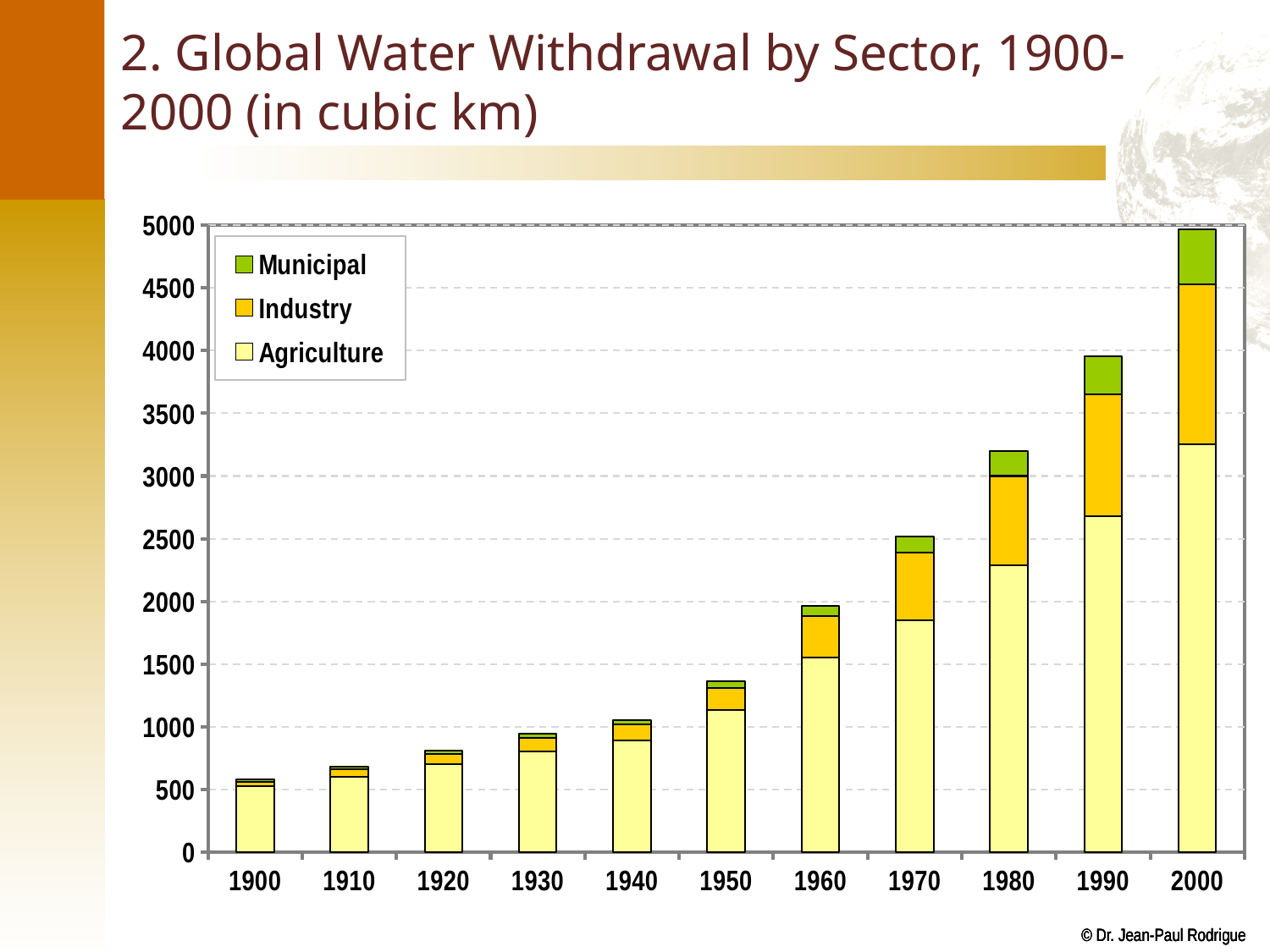
What kind of chart is shown on the slide? Stacked bar chart Is the total water withdrawal for 1950 greater or less than 1500? less Is the Agriculture value for 1970 greater or less than 2000? less How many years (bars) are shown along the x axis? 11 Which sector is shown in green in the legend? Municipal Is the Agriculture value for 2000 greater or less than 3000? greater Which year has the highest total water withdrawal? 2000 Which is larger in 2000, the Industry segment or the Municipal segment? Industry How many series does the legend list? 3 Do total water withdrawals rise or fall from 1900 to 2000? Rise Which year has the lowest total water withdrawal? 1900